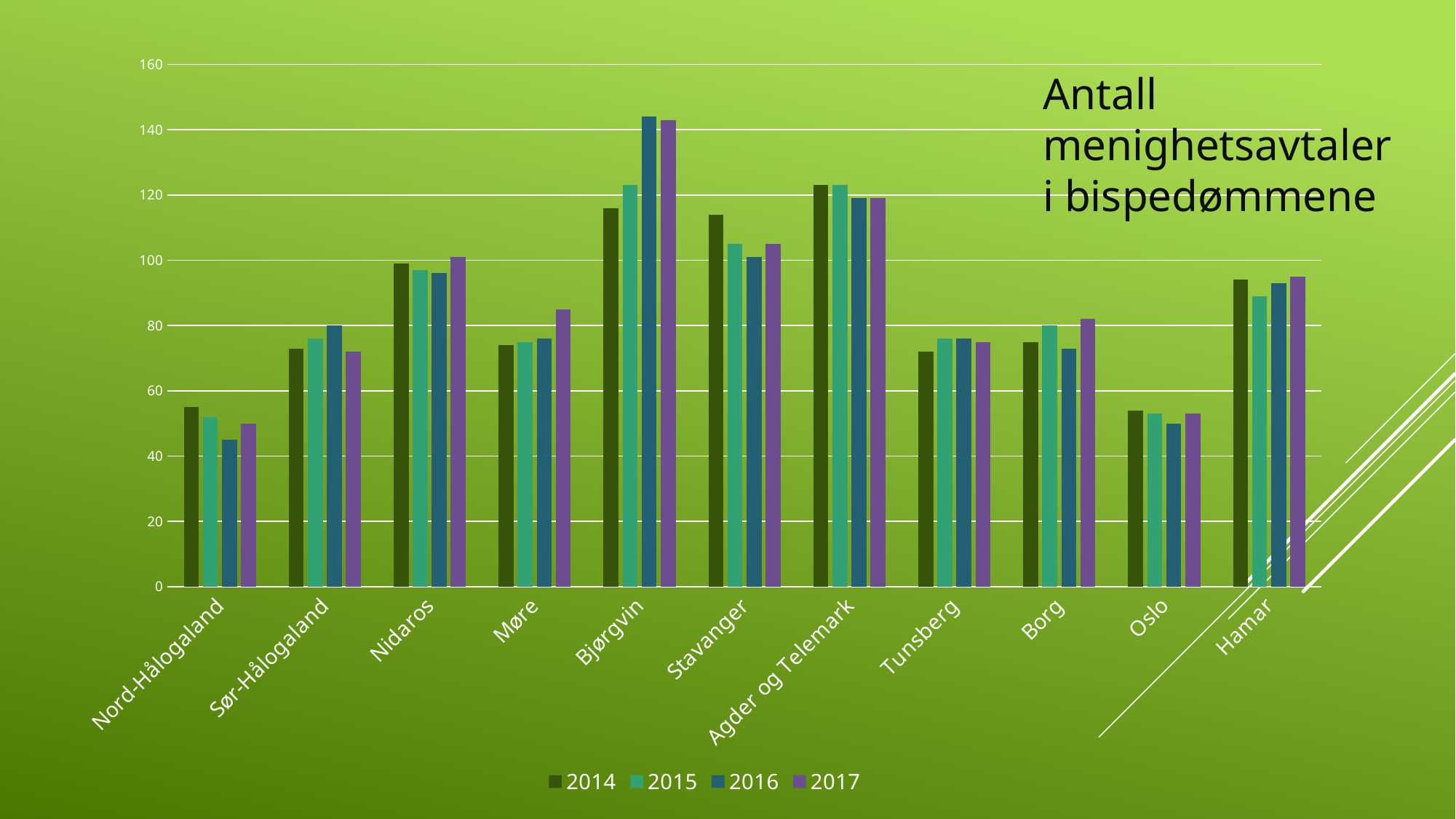
How many series does the legend list? 4 How many categories (bispedømmer) are shown on the x axis? 11 What kind of chart is shown on the slide? bar chart Which is larger, the 2017 value for Nidaros or the 2017 value for Møre? Nidaros Is the 2014 value for Agder og Telemark greater or less than 120? greater Is the 2014 value for Oslo greater or less than 60? less Which category has the tallest bar in the chart? Bjørgvin Which is larger, the 2014 value for Hamar or the 2014 value for Oslo? Hamar Which category has the shortest bar in the chart? Nord-Hålogaland What is the title of the chart? Antall menighetsavtaler i bispedømmene Is the 2016 value for Bjørgvin greater or less than 140? greater